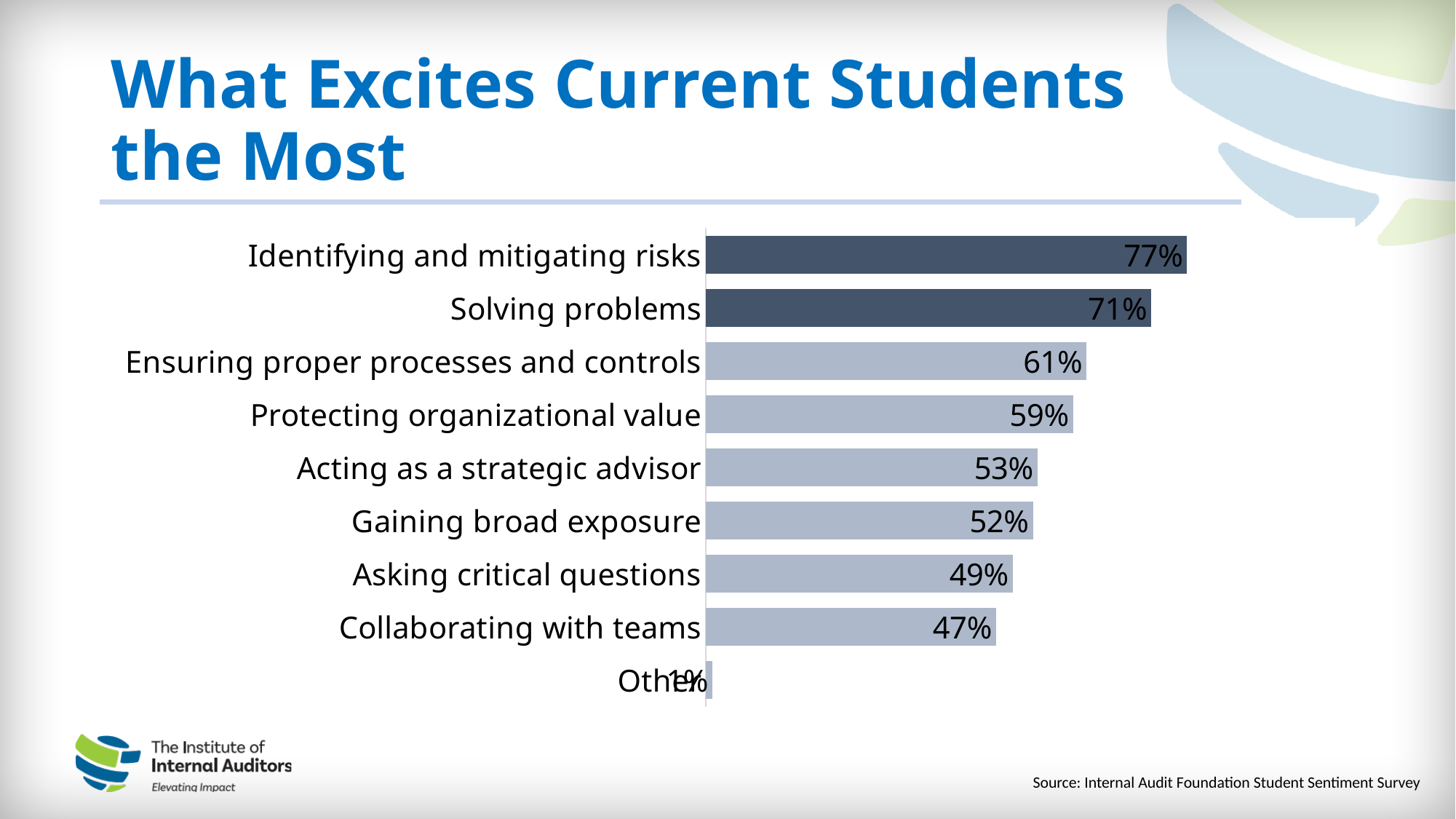
What kind of chart is shown on the slide? Bar chart What is the difference between Protecting organizational value and Asking critical questions? 10% Which is larger, the value for Acting as a strategic advisor or Gaining broad exposure? Acting as a strategic advisor What is the title of the slide containing the chart? What Excites Current Students the Most Which category has the highest value on the chart? Identifying and mitigating risks What percentage is shown for Ensuring proper processes and controls? 61% How many categories are shown on the chart? 9 What is the value shown for Solving problems? 71% What is the difference between the values for Identifying and mitigating risks and Solving problems? 6% Which category has the lowest value on the chart? Other What percentage of current students are excited by identifying and mitigating risks? 77% What is the value for Collaborating with teams? 47%